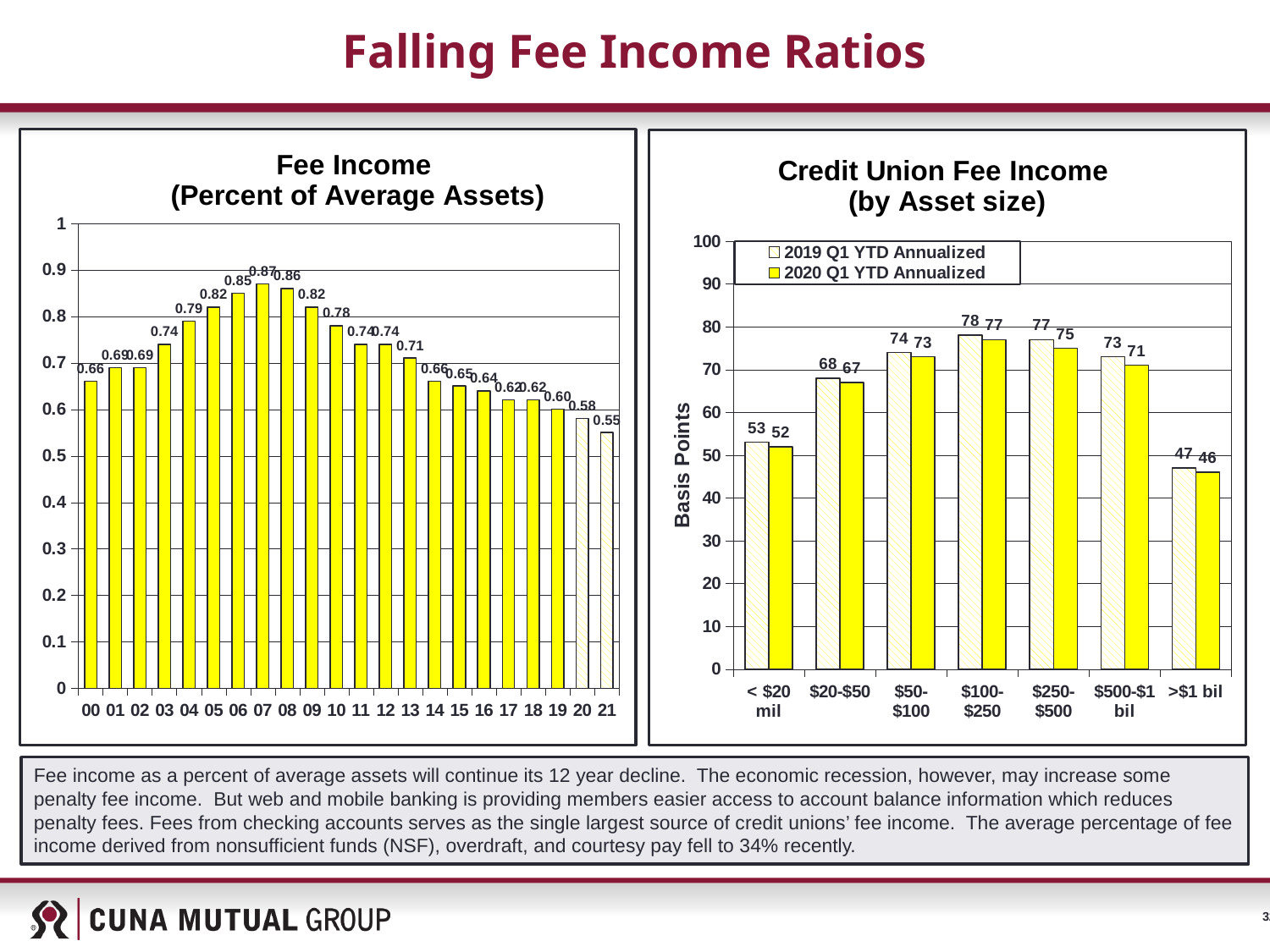
In the Fee Income (Percent of Average Assets) chart, do the values rise or fall from 09 to 21? fall In the Fee Income (Percent of Average Assets) chart, what is the value for 07? 0.87 In the Fee Income (Percent of Average Assets) chart, which year has the highest value? 07 In the Credit Union Fee Income (by Asset size) chart, which asset size has the lowest 2020 Q1 YTD Annualized value? >$1 bil In the Credit Union Fee Income (by Asset size) chart, which asset size has the highest 2019 Q1 YTD Annualized value? $100-$250 In the Fee Income (Percent of Average Assets) chart, how many years are plotted? 22 What kind of chart is the Credit Union Fee Income (by Asset size) chart? bar chart In the Fee Income (Percent of Average Assets) chart, what is the difference between the values for 07 and 21? 0.32 In the Credit Union Fee Income (by Asset size) chart, what is the 2020 Q1 YTD Annualized value for $250-$500? 75 In the Fee Income (Percent of Average Assets) chart, which year has the lowest value? 21 In the Credit Union Fee Income (by Asset size) chart, how many series does the legend list? 2 In the Credit Union Fee Income (by Asset size) chart, what is the difference between the 2019 and 2020 Q1 YTD Annualized values for $500-$1 bil? 2